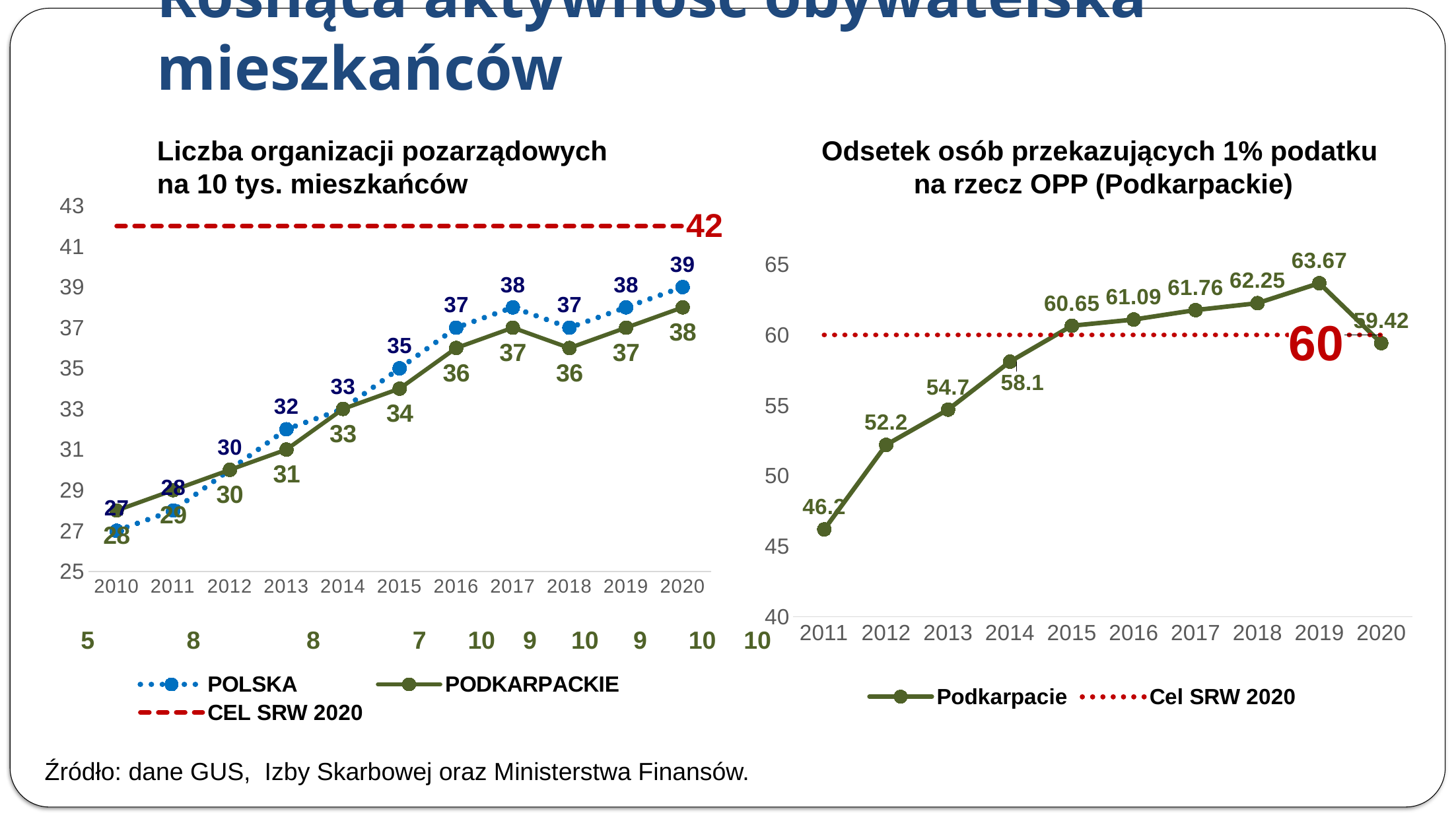
In the chart 'Odsetek osób przekazujących 1% podatku na rzecz OPP (Podkarpackie)', which year has the highest value? 2019 In the chart 'Odsetek osób przekazujących 1% podatku na rzecz OPP (Podkarpackie)', what value does the 'Cel SRW 2020' target line mark? 60 In the chart 'Liczba organizacji pozarządowych na 10 tys. mieszkańców', what is the PODKARPACKIE value for 2015? 34 In the chart 'Liczba organizacji pozarządowych na 10 tys. mieszkańców', which series has the higher value in 2020, POLSKA or PODKARPACKIE? POLSKA In the chart 'Odsetek osób przekazujących 1% podatku na rzecz OPP (Podkarpackie)', which year has the lowest value? 2011 In the chart 'Liczba organizacji pozarządowych na 10 tys. mieszkańców', by how much did the POLSKA value increase from 2010 to 2020? 12 In the chart 'Odsetek osób przekazujących 1% podatku na rzecz OPP (Podkarpackie)', how many years are plotted on the x axis? 10 In the chart 'Liczba organizacji pozarządowych na 10 tys. mieszkańców', what is the POLSKA value for 2020? 39 What kind of chart is 'Liczba organizacji pozarządowych na 10 tys. mieszkańców'? Line chart In the chart 'Odsetek osób przekazujących 1% podatku na rzecz OPP (Podkarpackie)', by how much did the value fall from 2019 to 2020? 4.25 In the chart 'Odsetek osób przekazujących 1% podatku na rzecz OPP (Podkarpackie)', what is the value for 2019? 63.67 In the chart 'Liczba organizacji pozarządowych na 10 tys. mieszkańców', how many series does the legend list? 3